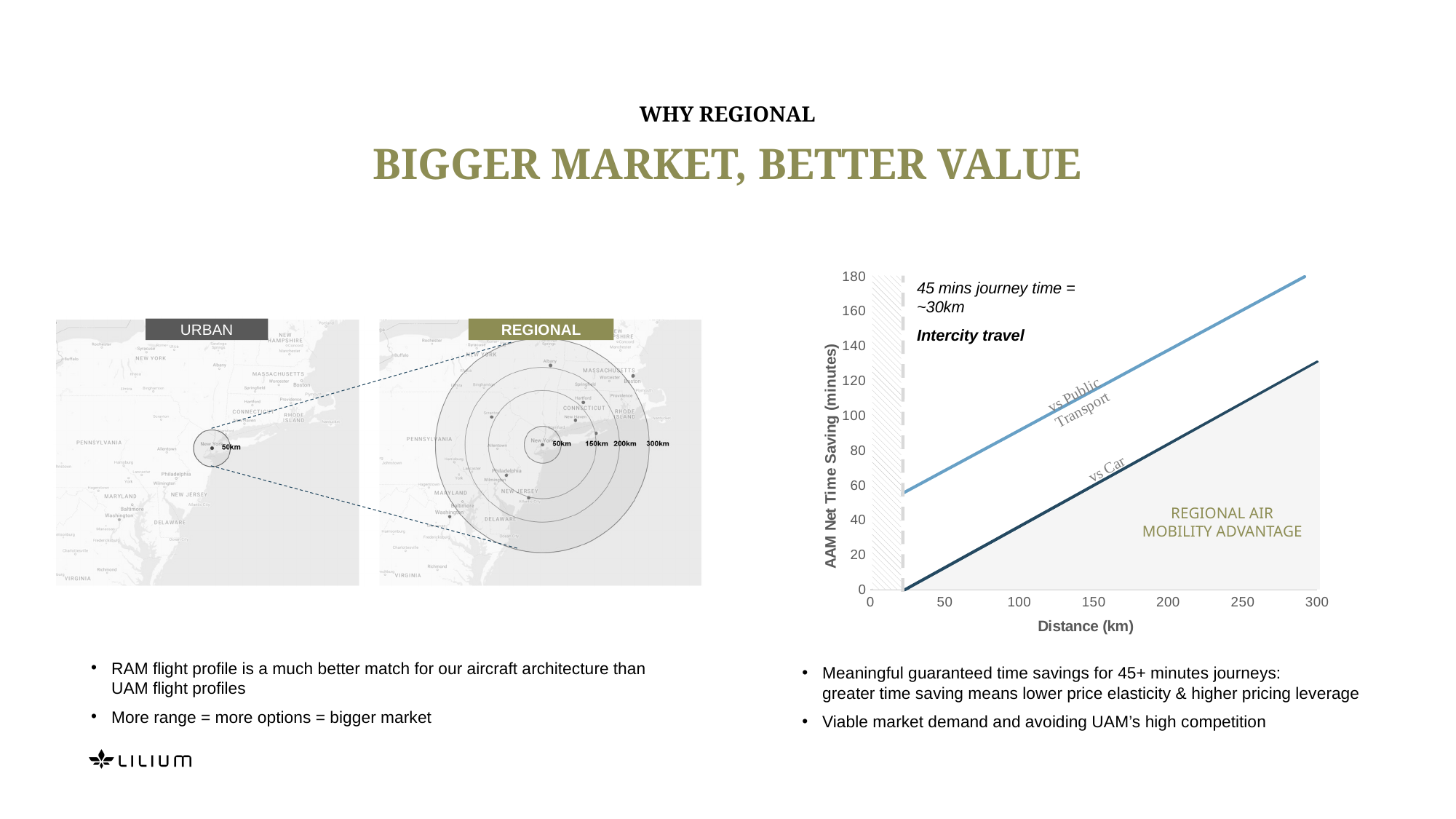
On the AAM Net Time Saving chart, is the 'vs Public Transport' value at 150 km greater or less than 100? greater On the AAM Net Time Saving chart, is the 'vs Car' value at 150 km greater or less than 80? less On the AAM Net Time Saving chart, which line is higher at 150 km: 'vs Public Transport' or 'vs Car'? vs Public Transport On the AAM Net Time Saving chart, does the 'vs Car' line rise or fall as distance increases? rise What is the x-axis label of the chart on the right side of the slide? Distance (km) On the AAM Net Time Saving chart, is the 'vs Car' value at 300 km greater or less than 100? greater What kind of chart is shown on the right side of the slide? line chart How many lines are plotted on the AAM Net Time Saving chart? 2 On the AAM Net Time Saving chart, does the 'vs Public Transport' line rise or fall as distance increases? rise What is the y-axis label of the chart on the right side of the slide? AAM Net Time Saving (minutes)